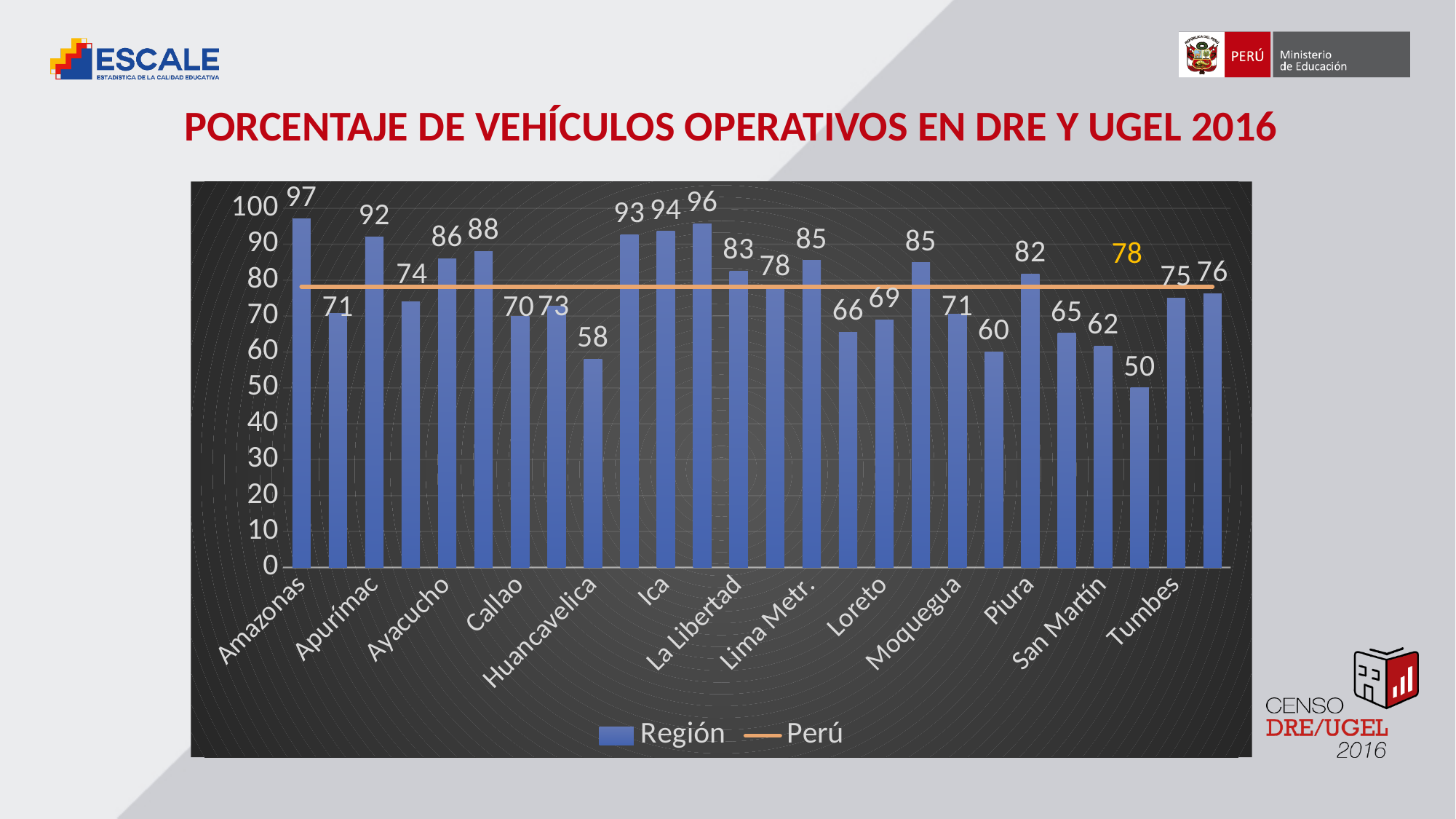
What is the value for Callao? 70 What value does the Perú line show? 78 What is the value for Amazonas? 97 Is the value for Huancavelica greater or less than the Perú line value of 78? less What is the lowest value shown by any bar on the chart? 50 How many series does the legend list? 2 What is the difference between the values for Amazonas and Huancavelica? 39 Which labeled region has the highest value? Amazonas Which is larger, the value for Apurímac or the value for Callao? Apurímac What is the value for Huancavelica? 58 What is the value for Apurímac? 92 What kind of chart is shown on the slide? Combination bar and line chart